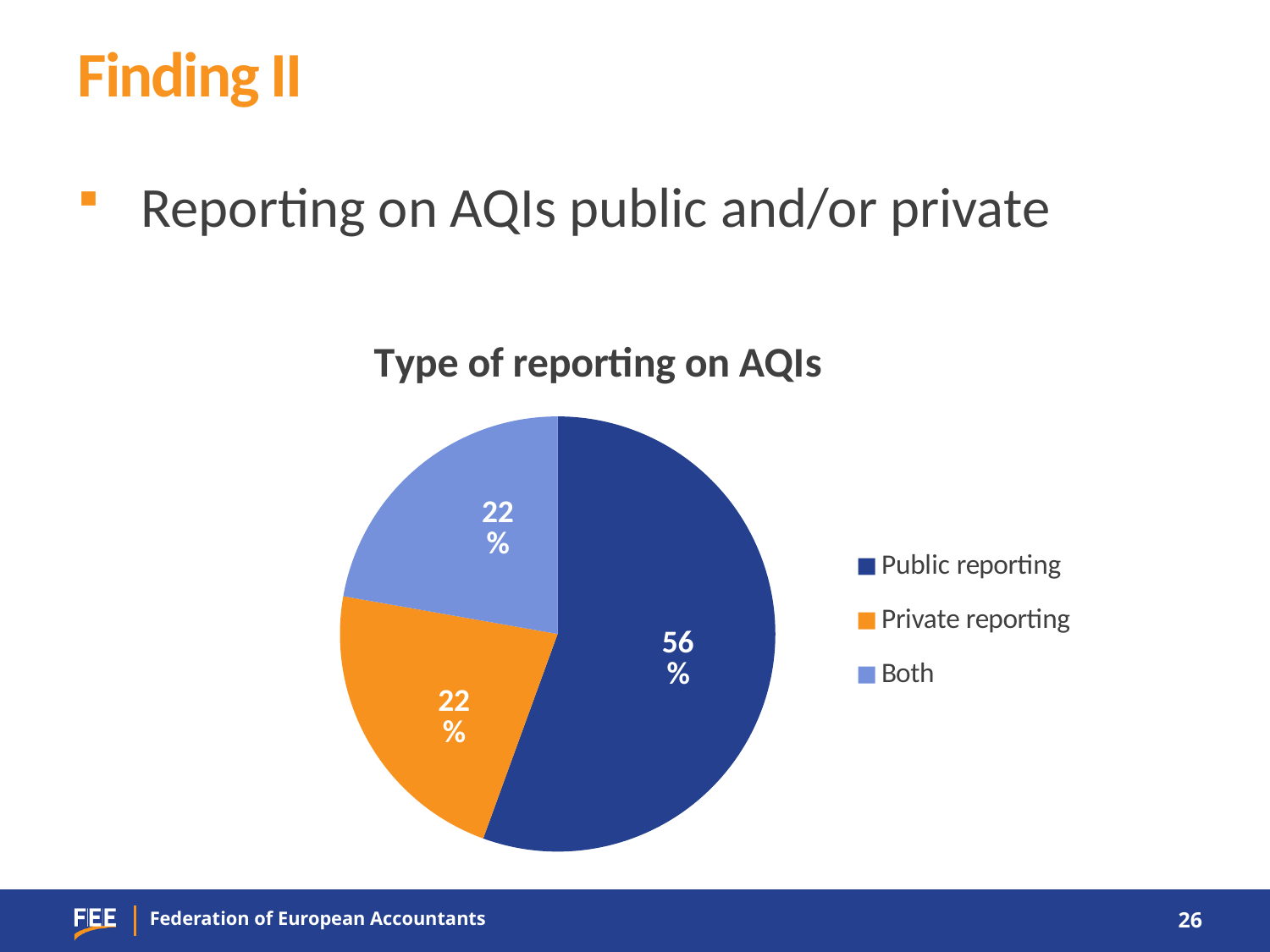
How many slices does the pie chart have? 3 What share of the pie is Both? 22% Which is larger, the slice for Public reporting or the slice for Both? Public reporting What share of the pie is Private reporting? 22% Is the share for Public reporting greater or less than 50%? greater Which colour represents Private reporting in the chart? orange Which category has the largest slice of the pie? Public reporting What kind of chart is shown on the slide? pie chart What share of the pie is Public reporting? 56% What is the title of the chart? Type of reporting on AQIs How many entries does the legend list? 3 What is the difference in percentage points between Public reporting and Private reporting? 34